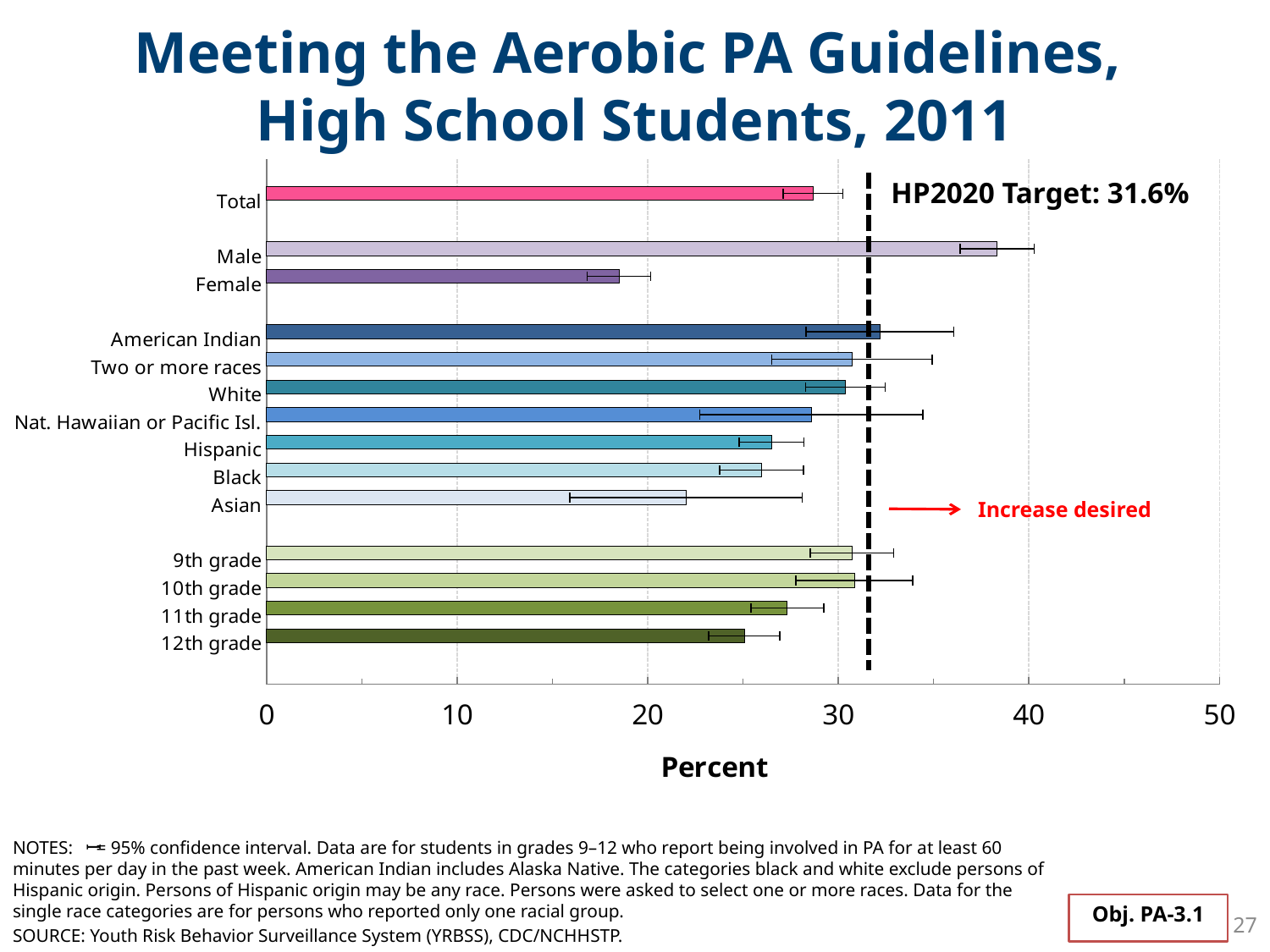
Is the value for 12th grade greater or less than 30? less Which is larger, the value for Black or the value for Asian? Black Which category has the lowest value in the chart? Female How many categories (bars) are plotted in the chart? 14 Is the value for Male greater or less than 30? greater What type of chart is shown on the slide? bar chart Which is larger, the value for 9th grade or the value for 12th grade? 9th grade Which category has the highest value in the chart? Male What is the HP2020 Target value shown on the chart? 31.6% Is the value for Female greater or less than 20? less What is the label of the x axis? Percent